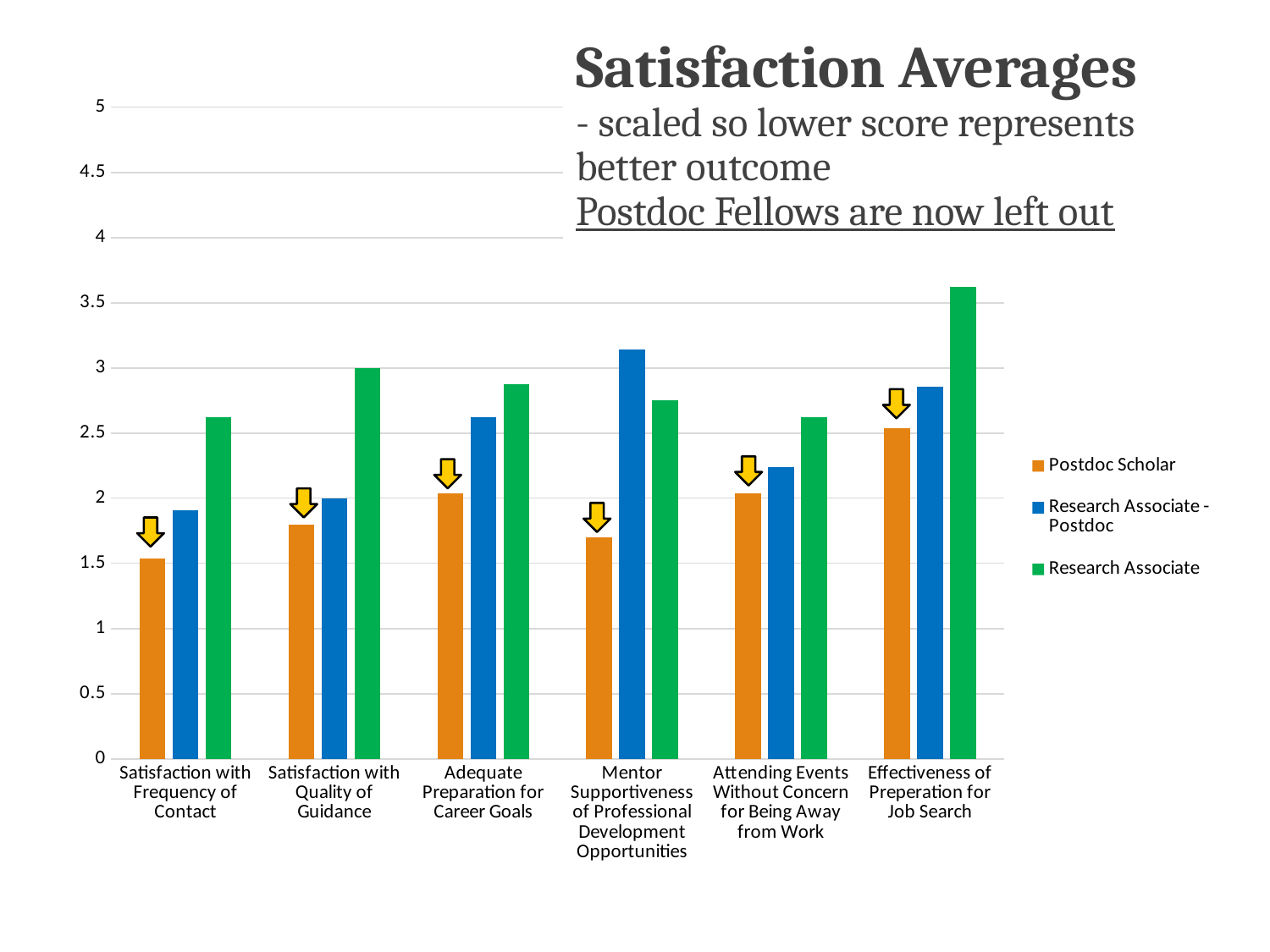
How many series does the legend list? 3 Is the Research Associate value for Satisfaction with Frequency of Contact greater or less than 3? less What colour represents the Postdoc Scholar series? orange Is the Postdoc Scholar value for Mentor Supportiveness of Professional Development Opportunities greater or less than 2? less Which series has the highest value for Satisfaction with Quality of Guidance? Research Associate For Effectiveness of Preperation for Job Search, which is larger: Postdoc Scholar or Research Associate? Research Associate Which category has the lowest Postdoc Scholar value? Satisfaction with Frequency of Contact Is the Research Associate - Postdoc value for Mentor Supportiveness of Professional Development Opportunities greater or less than 3? greater Which category has the highest Research Associate value? Effectiveness of Preperation for Job Search What kind of chart is shown on the slide? bar chart For Mentor Supportiveness of Professional Development Opportunities, which is larger: Research Associate - Postdoc or Research Associate? Research Associate - Postdoc How many categories are shown along the x axis? 6